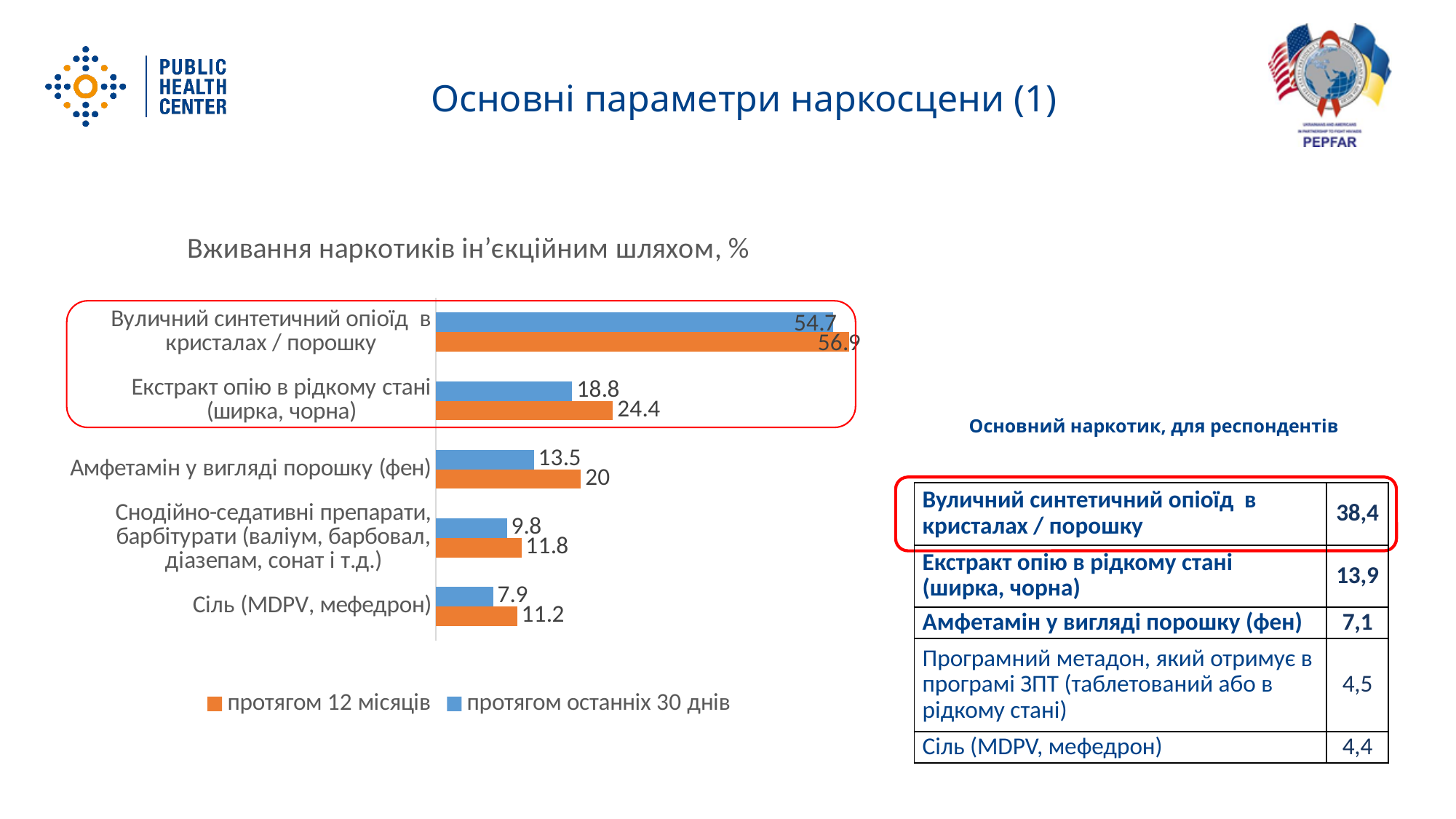
How many series does the chart legend list? 2 What is the value for "Вуличний синтетичний опіоїд в кристалах / порошку" in the "протягом 12 місяців" series? 56.9 What is the title of the chart? Вживання наркотиків ін'єкційним шляхом, % Which category has the highest value in the "протягом 12 місяців" series? Вуличний синтетичний опіоїд в кристалах / порошку What is the difference between the "протягом 12 місяців" and "протягом останніх 30 днів" values for "Екстракт опію в рідкому стані (ширка, чорна)"? 5.6 Which category has the lowest value in the "протягом останніх 30 днів" series? Сіль (MDPV, мефедрон) What is the value for "Сіль (MDPV, мефедрон)" in the "протягом останніх 30 днів" series? 7.9 How many categories are shown in the chart? 5 What is the value for "Амфетамін у вигляді порошку (фен)" in the "протягом 12 місяців" series? 20 Which is larger for "Амфетамін у вигляді порошку (фен)": the "протягом 12 місяців" value or the "протягом останніх 30 днів" value? протягом 12 місяців What type of chart is shown on the slide? Bar chart What is the value for "Екстракт опію в рідкому стані (ширка, чорна)" in the "протягом останніх 30 днів" series? 18.8